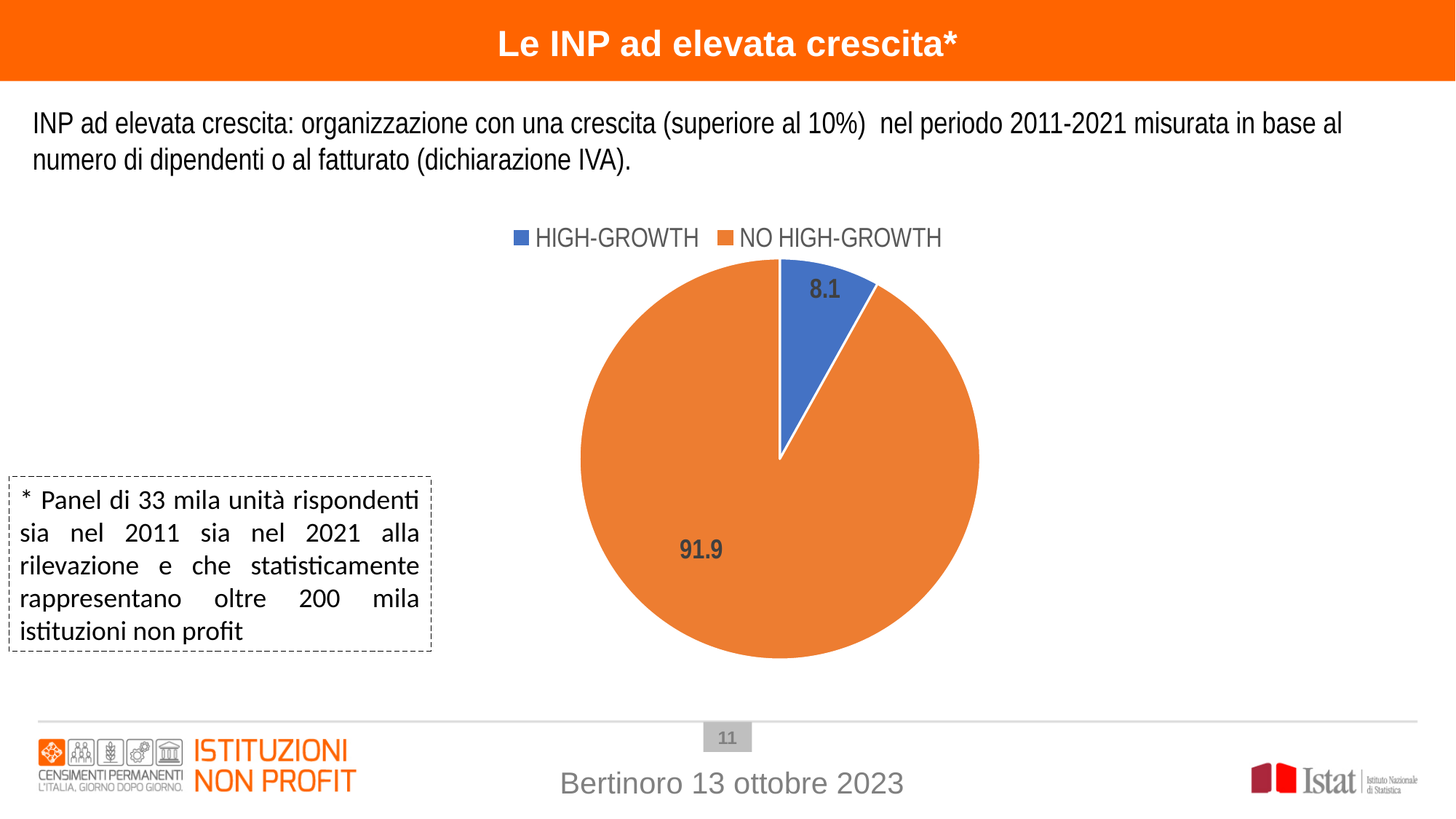
What is the value for HIGH-GROWTH? 8.1 How many entries does the legend list? 2 What kind of chart is shown on the slide? pie chart Which is larger, HIGH-GROWTH or NO HIGH-GROWTH? NO HIGH-GROWTH Which slice is the largest? NO HIGH-GROWTH What is the total of the two slice values? 100 Which slice is the smallest? HIGH-GROWTH What is the difference between the NO HIGH-GROWTH and HIGH-GROWTH values? 83.8 What colour is the NO HIGH-GROWTH slice? orange What colour is the HIGH-GROWTH slice? blue What is the value for NO HIGH-GROWTH? 91.9 How many slices does the pie chart have? 2